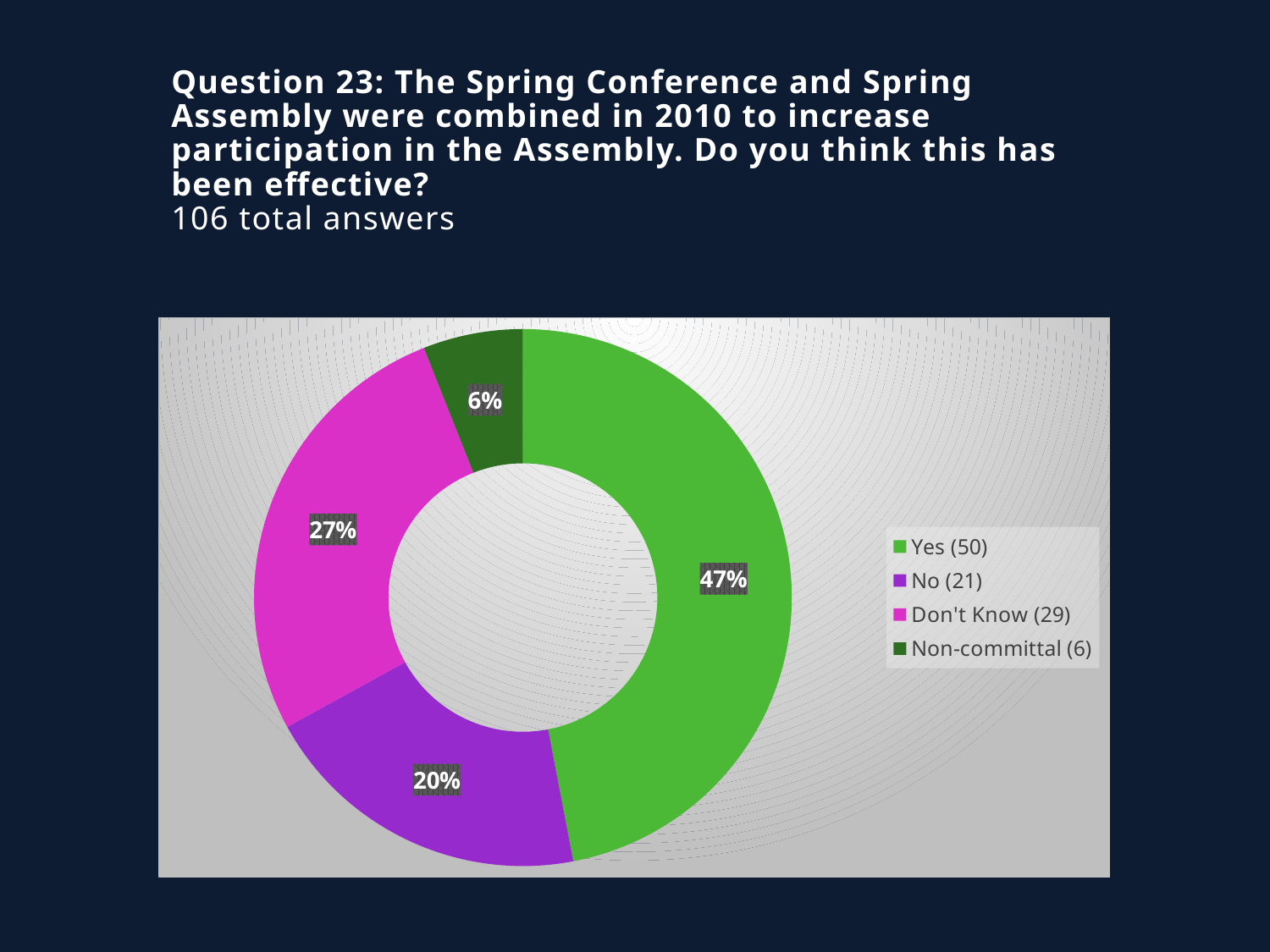
What colour is the 'Don't Know' slice in the chart? Magenta What kind of chart is shown on the slide? Doughnut chart What percentage of the doughnut chart is the 'No' slice? 20% Which response category has the smallest share of the chart? Non-committal According to the legend, how many respondents answered 'No'? 21 What percentage of the doughnut chart is the 'Don't Know' slice? 27% What percentage of the doughnut chart is the 'Yes' slice? 47% What is the difference in percentage points between the 'Yes' slice and the 'Don't Know' slice? 20 What percentage of the doughnut chart is the 'Non-committal' slice? 6% Which response category has the largest share of the chart? Yes How many categories does the chart show? 4 Which slice is larger, 'No' or 'Don't Know'? Don't Know